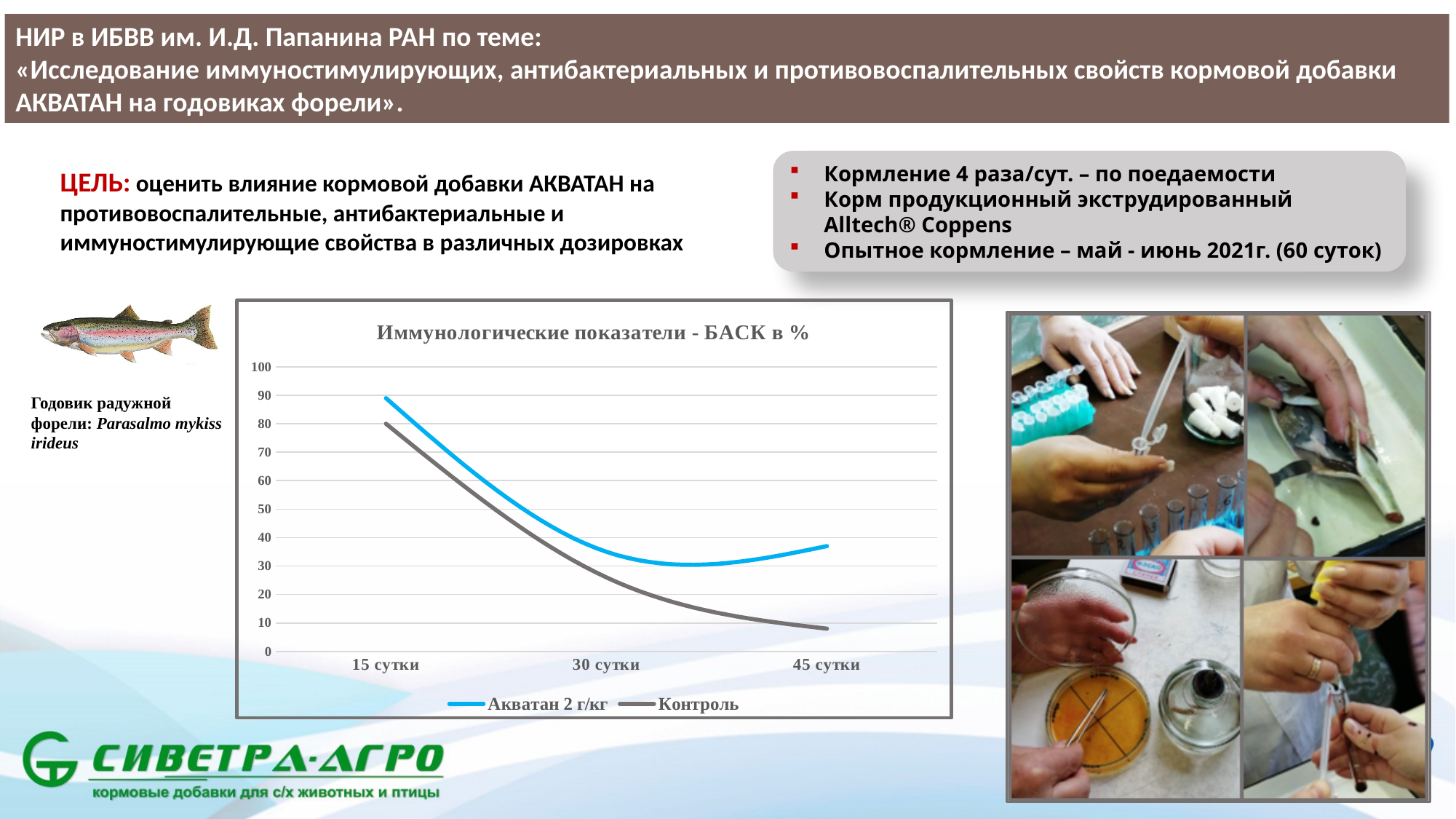
At which time point does the Акватан 2 г/кг series reach its highest value? 15 сутки How many time points are shown on the x axis of the chart? 3 Is the value for Контроль at 45 сутки greater or less than 20? less What kind of chart is shown under the title "Иммунологические показатели - БАСК в %"? line chart Which series is drawn in blue on the chart? Акватан 2 г/кг Is the value for Контроль at 30 сутки greater or less than 40? less Which series has the higher value at 45 сутки, Акватан 2 г/кг or Контроль? Акватан 2 г/кг Is the value for Акватан 2 г/кг at 45 сутки greater or less than 30? greater How many series does the legend of the chart list? 2 What is the title of the chart? Иммунологические показатели - БАСК в % Does the Контроль line rise or fall from 15 сутки to 45 сутки? fall